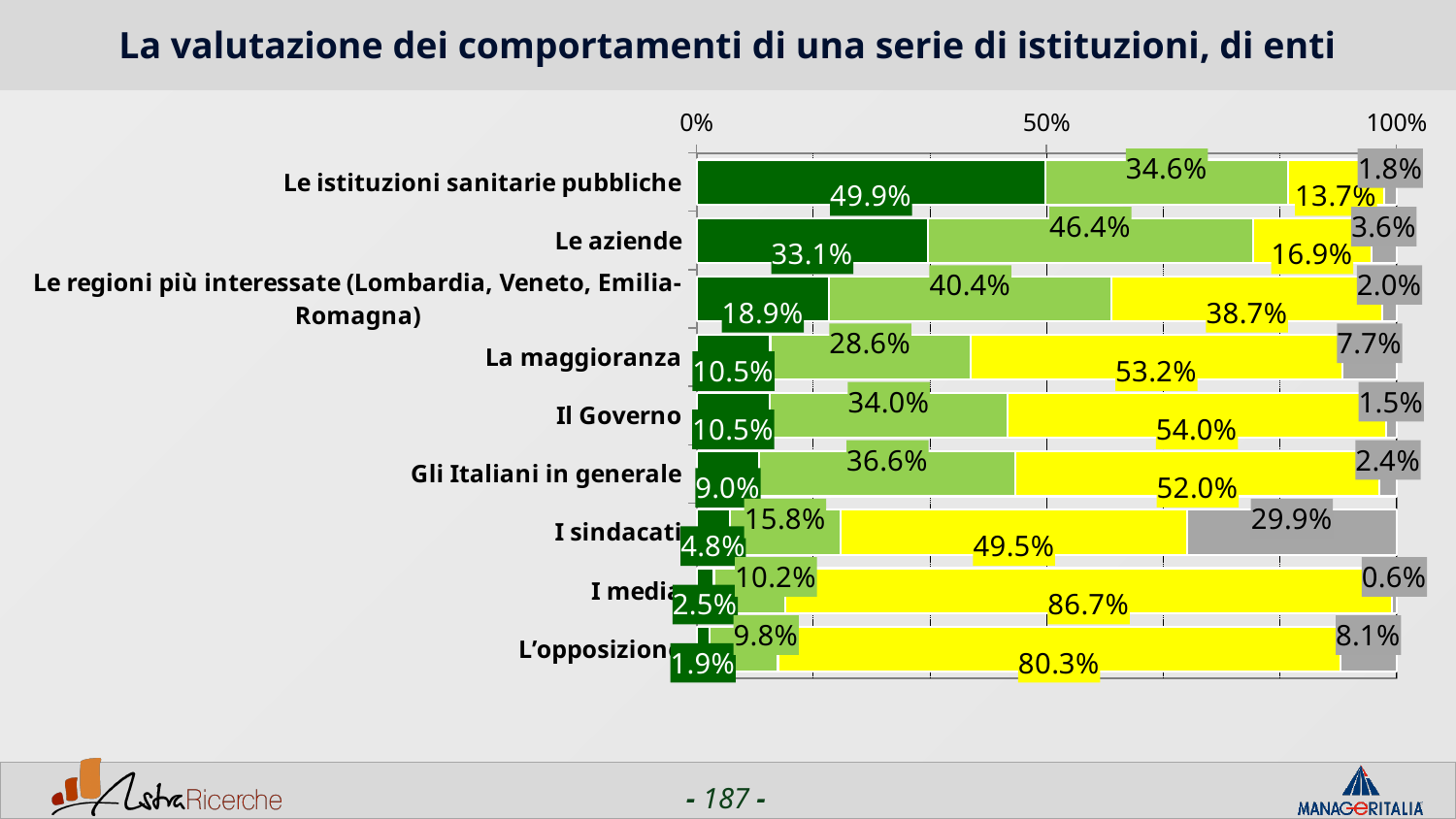
Which has a larger dark green segment, Le aziende or Le regioni più interessate (Lombardia, Veneto, Emilia-Romagna)? Le aziende Which category has the largest yellow segment? I media Which category has the largest dark green segment? Le istituzioni sanitarie pubbliche What is the value of the grey segment for I sindacati? 29.9% How many coloured segments make up each bar? 4 What kind of chart is shown on the slide? Stacked bar chart What is the difference between the yellow segment for I media and the yellow segment for L'opposizione? 6.4 percentage points Which category has the smallest dark green segment? L'opposizione How many categories (institutions) are shown in the chart? 9 What is the value of the light green segment for Le aziende? 46.4% What is the value of the dark green segment for Le istituzioni sanitarie pubbliche? 49.9% What is the value of the yellow segment for I media? 86.7%